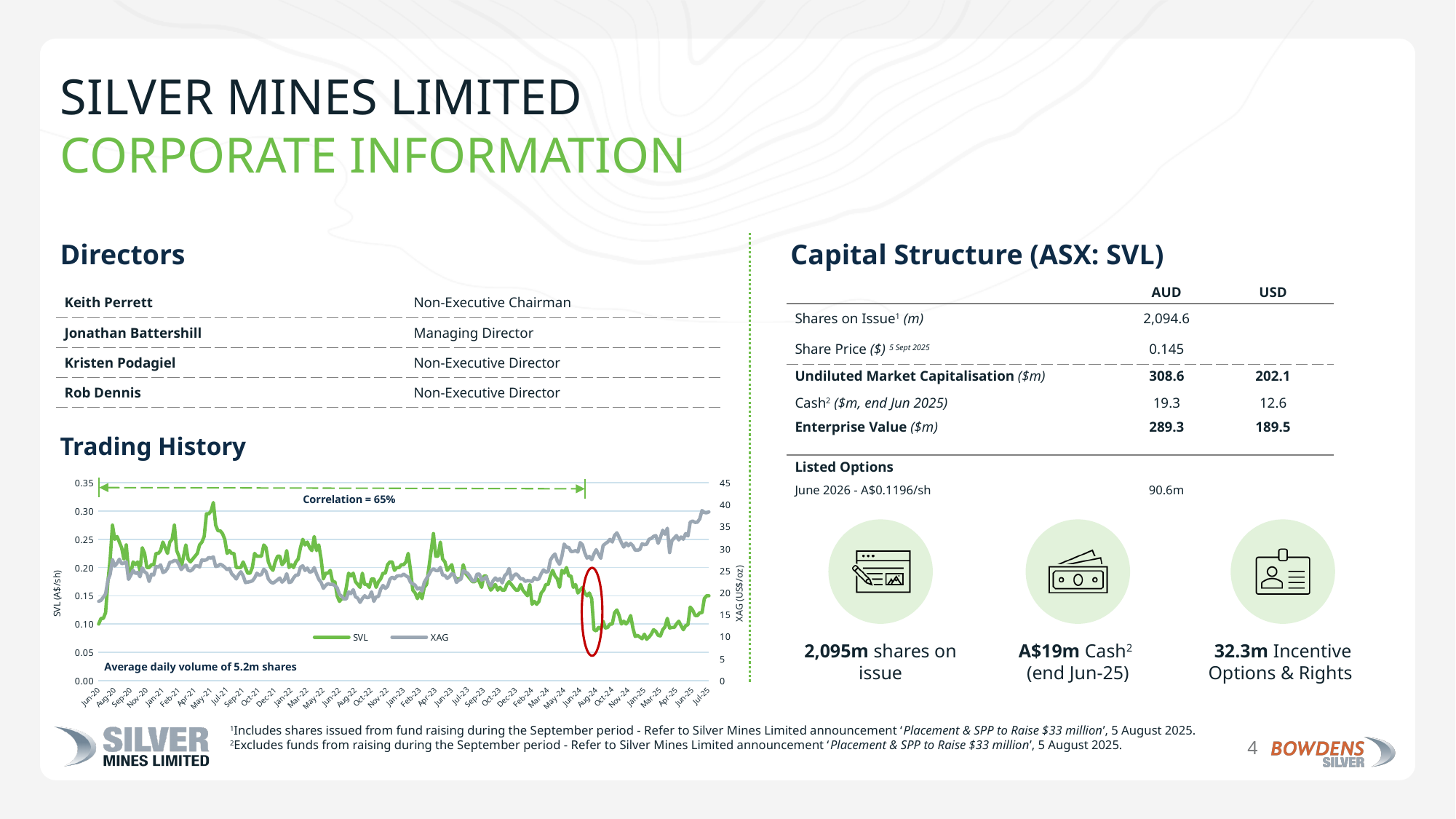
On the Trading History chart, in which month does the SVL series reach its highest point? Jun-21 What correlation value is annotated on the Trading History chart? 65% How many series does the legend of the Trading History chart list? 2 What average daily volume is stated on the Trading History chart? 5.2m shares On the Trading History chart, is the peak SVL value greater or less than 0.30? greater On the Trading History chart, is the XAG value at Jul-25 greater or less than 35? greater On the Trading History chart, does the SVL series rise or fall between Jun-24 and Jan-25? fall On the Trading History chart, is the SVL value at Jan-25 greater or less than 0.10? less On the Trading History chart, does the XAG series rise or fall between Jun-24 and Jul-25? rise What kind of chart is the Trading History chart? line chart